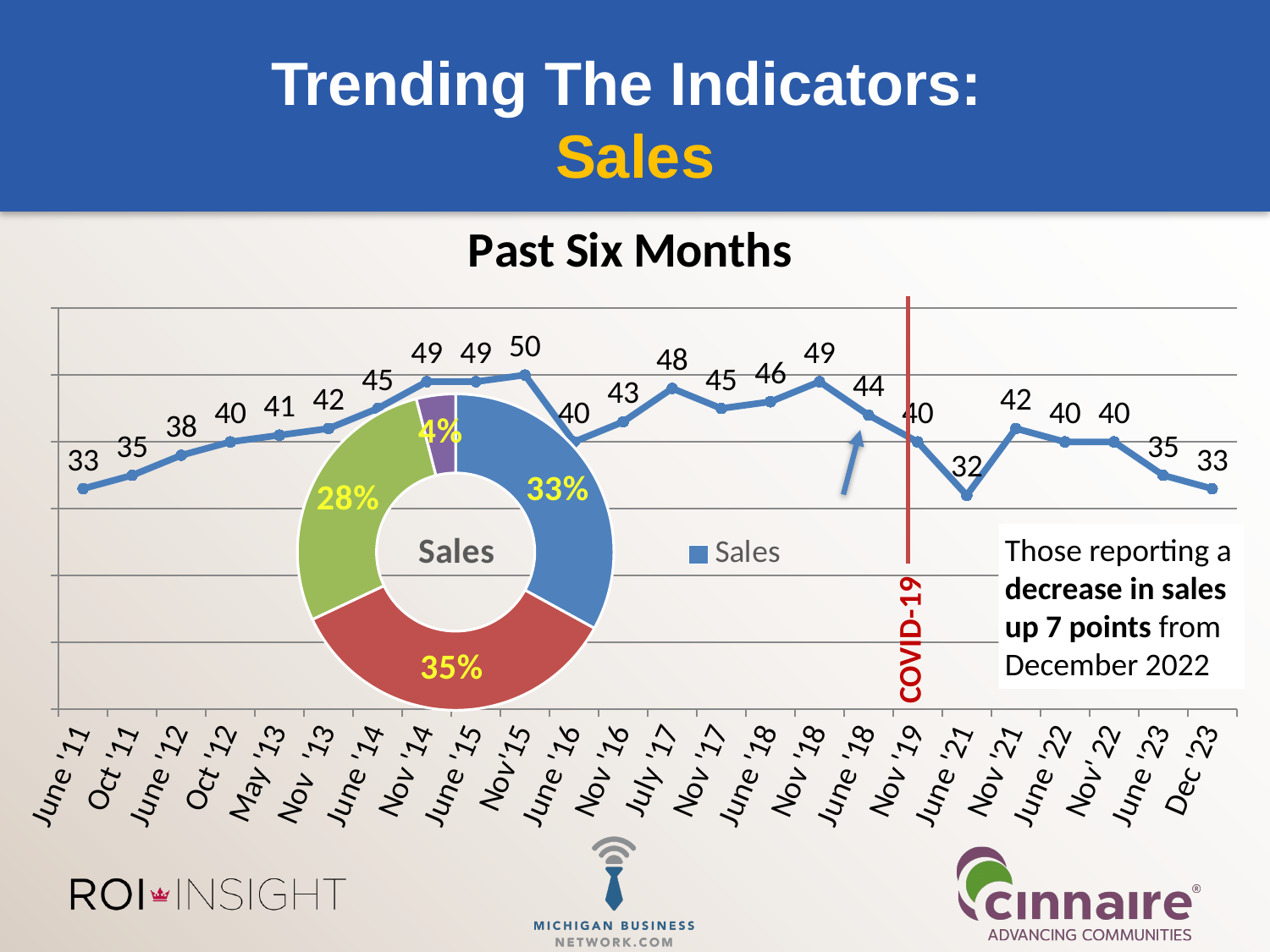
On the Past Six Months line chart, which is larger, the value for July '17 or the value for Nov '17? July '17 On the Past Six Months line chart, what is the difference between the values for Nov '18 and June '21? 17 On the Past Six Months line chart, which period has the highest value? Nov '15 On the Past Six Months line chart, what is the value for Nov '15? 50 What kind of chart is the Past Six Months chart? line chart On the Sales donut chart, what share does the red slice show? 35% On the Past Six Months line chart, which period has the lowest value? June '21 On the Past Six Months line chart, what is the value for June '21? 32 How many data points are plotted on the Past Six Months line chart? 24 On the Past Six Months line chart, do the values rise or fall from June '11 to Nov '15? rise On the Past Six Months line chart, what is the value for Dec '23? 33